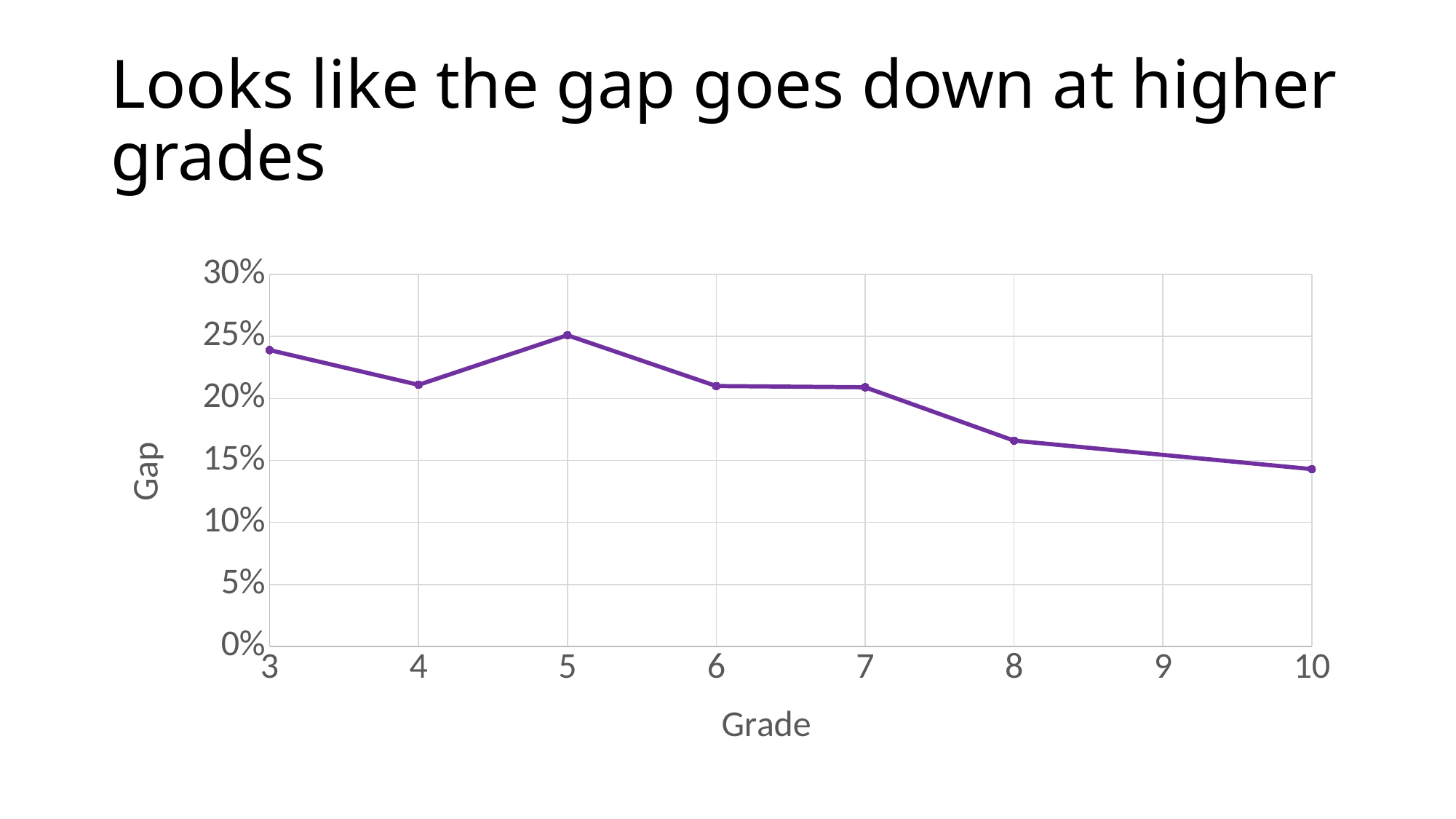
At which grade is the gap lowest? 10 How many grade labels are shown on the x axis? 8 At which grade is the gap highest? 5 Which has the larger gap, grade 5 or grade 10? grade 5 What kind of chart is shown on the slide? line chart Is the gap at grade 8 greater or less than 15%? greater Overall, does the gap rise or fall as grade increases? fall Which has the larger gap, grade 3 or grade 8? grade 3 What is the label on the vertical axis of the chart? Gap Is the gap at grade 3 greater or less than 20%? greater Is the gap at grade 10 greater or less than 15%? less